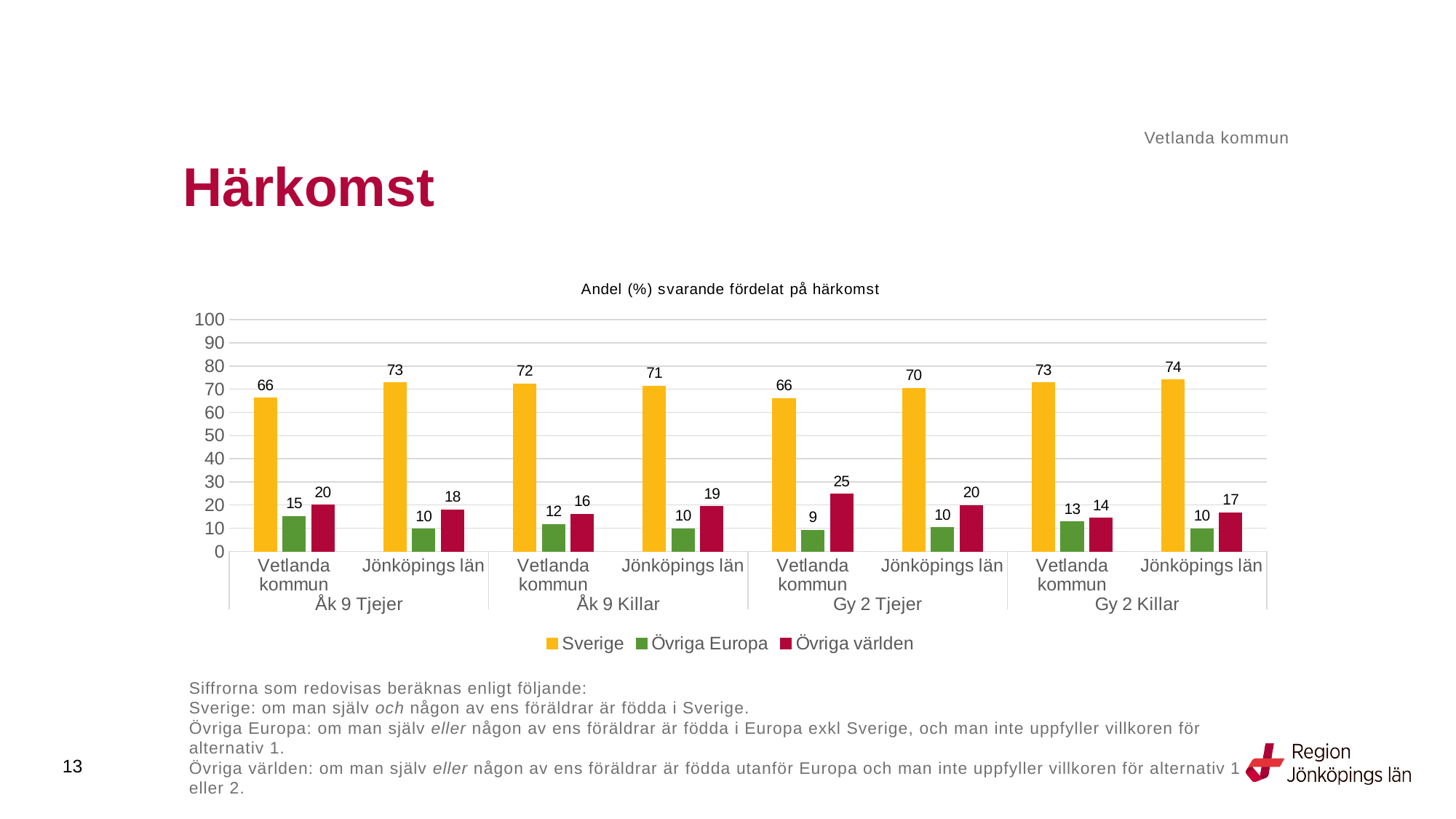
What is the value for Övriga världen for Vetlanda kommun in the Gy 2 Tjejer group? 25 What kind of chart is shown on the slide? Bar chart What is the title of the chart? Andel (%) svarande fördelat på härkomst How many category groups (bar clusters) are shown along the x axis? 8 Is the Sverige value for Vetlanda kommun in the Åk 9 Killar group greater or less than 50? greater How many series does the legend list? 3 What is the value for Sverige for Vetlanda kommun in the Åk 9 Tjejer group? 66 What is the difference between the Sverige values for Vetlanda kommun and Jönköpings län in the Åk 9 Tjejer group? 7 Which is larger: the Övriga världen value for Vetlanda kommun in Gy 2 Tjejer or in Gy 2 Killar? Gy 2 Tjejer Which category has the lowest Övriga Europa value? Vetlanda kommun, Gy 2 Tjejer Which category has the highest Sverige value? Jönköpings län, Gy 2 Killar What is the value for Övriga Europa for Jönköpings län in the Gy 2 Killar group? 10